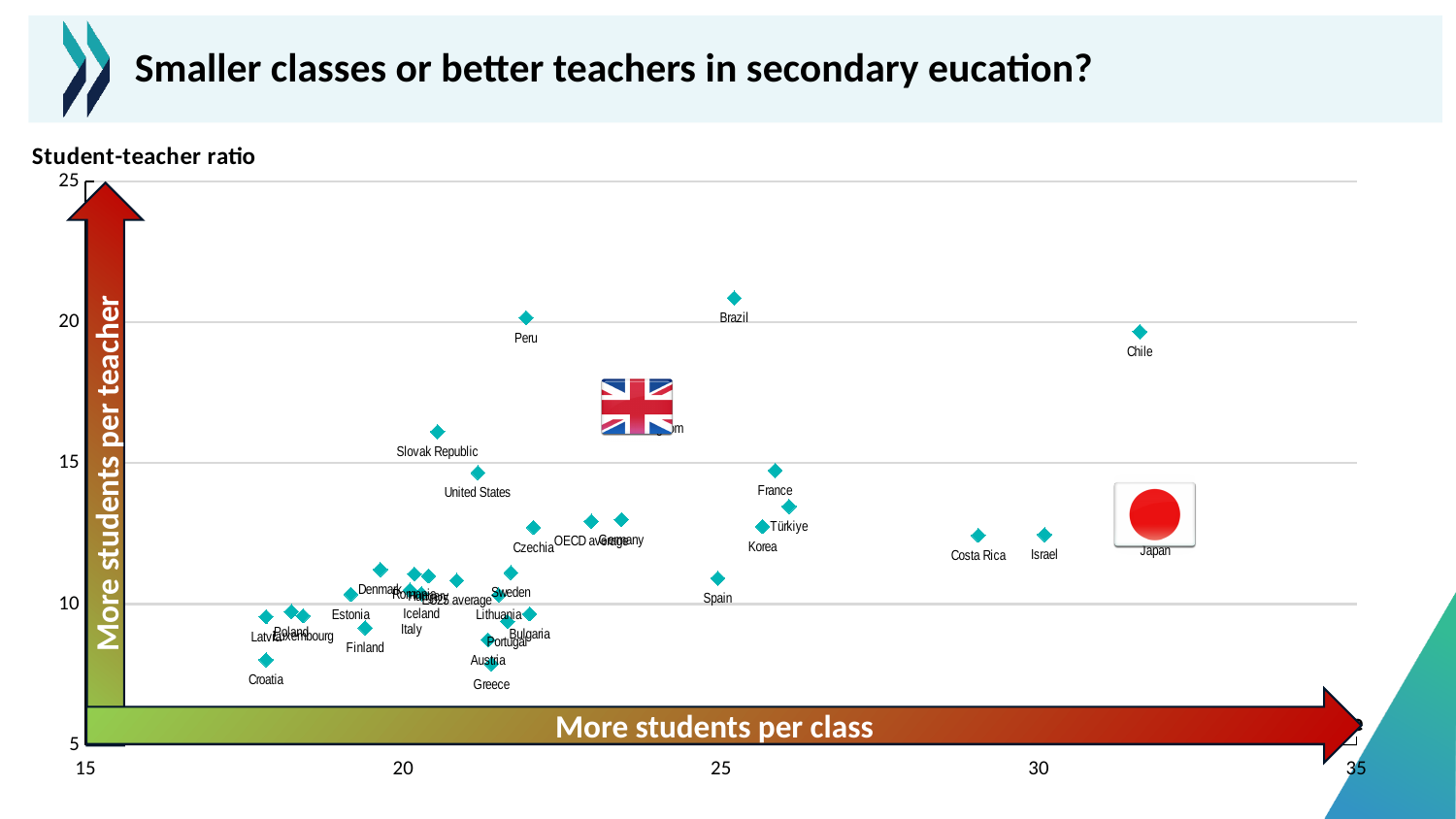
Which has more students per teacher, Brazil or Chile? Brazil Is the students-per-teacher value for the Slovak Republic greater or less than 15? greater Is the students-per-teacher value for Brazil greater or less than 20? greater What is the label on the vertical axis arrow of the chart? More students per teacher Is the students-per-teacher value for Croatia greater or less than 10? less Which country has the highest number of students per teacher? Brazil What kind of chart is shown on the slide? scatter chart